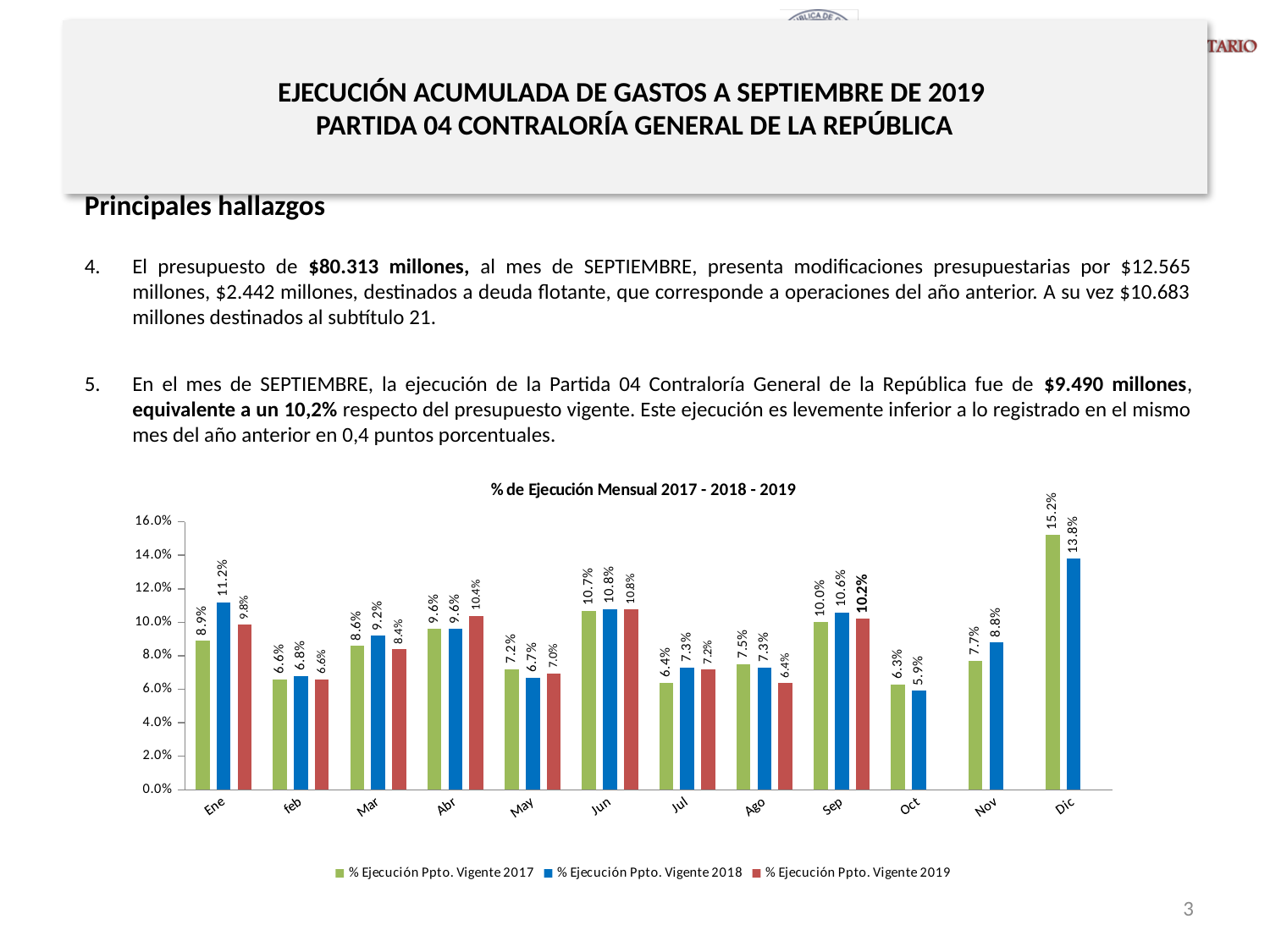
For Ene, which series has the larger value: % Ejecución Ppto. Vigente 2018 or % Ejecución Ppto. Vigente 2019? % Ejecución Ppto. Vigente 2018 Is the value for Oct in the % Ejecución Ppto. Vigente 2018 series greater or less than 6.0%? less What is the value for Sep in the % Ejecución Ppto. Vigente 2019 series? 10.2% What kind of chart is shown on the slide? Bar chart What is the title of the chart? % de Ejecución Mensual 2017 - 2018 - 2019 Which month has the lowest value in the % Ejecución Ppto. Vigente 2019 series? Ago What is the value for Dic in the % Ejecución Ppto. Vigente 2017 series? 15.2% How many series does the chart legend list? 3 How many months are shown on the x axis of the chart? 12 Which month has the highest value in the % Ejecución Ppto. Vigente 2018 series? Dic What is the difference between the 2017 and 2018 values for Dic? 1.4% What is the value for Ene in the % Ejecución Ppto. Vigente 2018 series? 11.2%